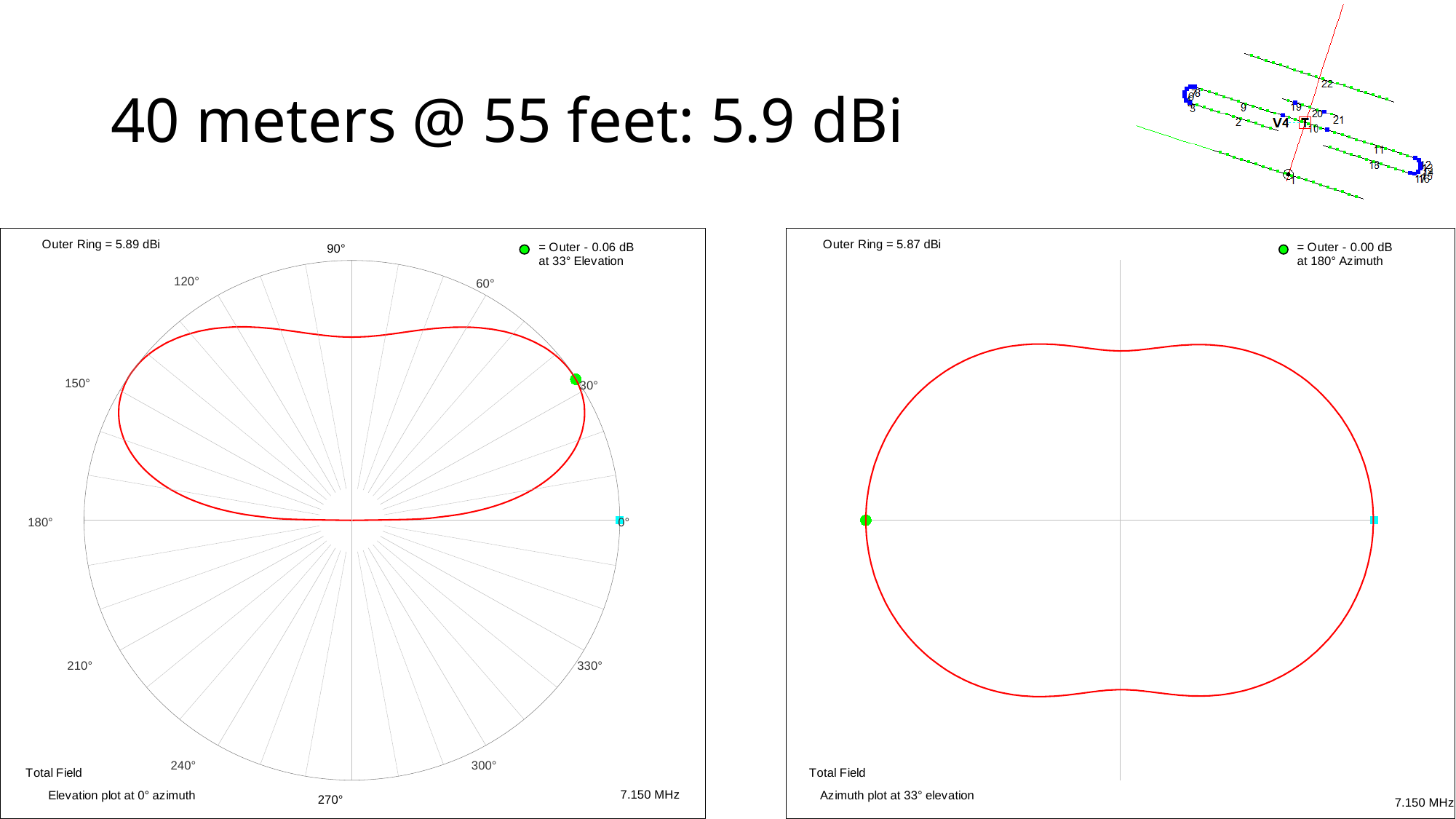
On the right chart, at what azimuth is the marked point located? 180° On the left chart (Elevation plot at 0° azimuth), what is the value of the outer ring? 5.89 dBi On the left chart, how far below the outer ring is the marked point? 0.06 dB On the right chart, how far below the outer ring is the marked point? 0.00 dB On the left chart, at what elevation angle is the marked point located? 33° What is the title text at the bottom of the right chart describing the plot? Azimuth plot at 33° elevation On the right chart (Azimuth plot at 33° elevation), what is the value of the outer ring? 5.87 dBi What is the difference between the outer ring values of the left and right charts? 0.02 dBi What type of chart is the left chart? polar plot Which chart has the larger outer ring value, the left elevation plot or the right azimuth plot? the left elevation plot What frequency is shown on the left chart? 7.150 MHz What field quantity is plotted on both charts, as labelled in the lower left corner? Total Field